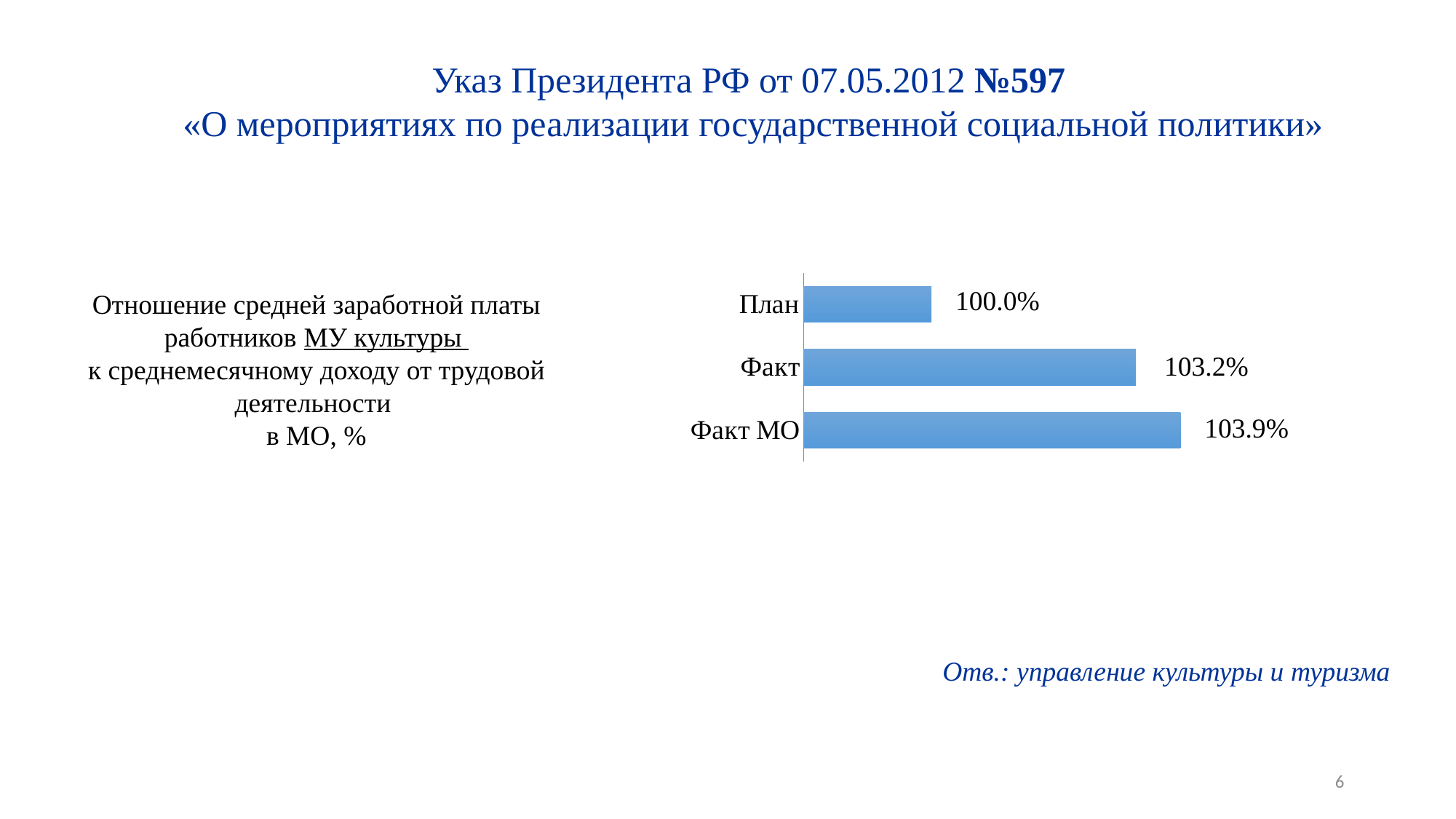
Which category has the highest value? Факт МО What is the difference between Факт МО and Факт? 0.7% What is the value for Факт МО? 103.9% What kind of chart is shown on the slide? bar chart What is the difference between Факт and План? 3.2% How many categories are shown in the chart? 3 What colour are the bars in the chart? blue Which category has the lowest value? План Which is larger, the value for Факт or the value for План? Факт What is the value for План? 100.0% Are the bars in the chart horizontal or vertical? horizontal What is the value for Факт? 103.2%